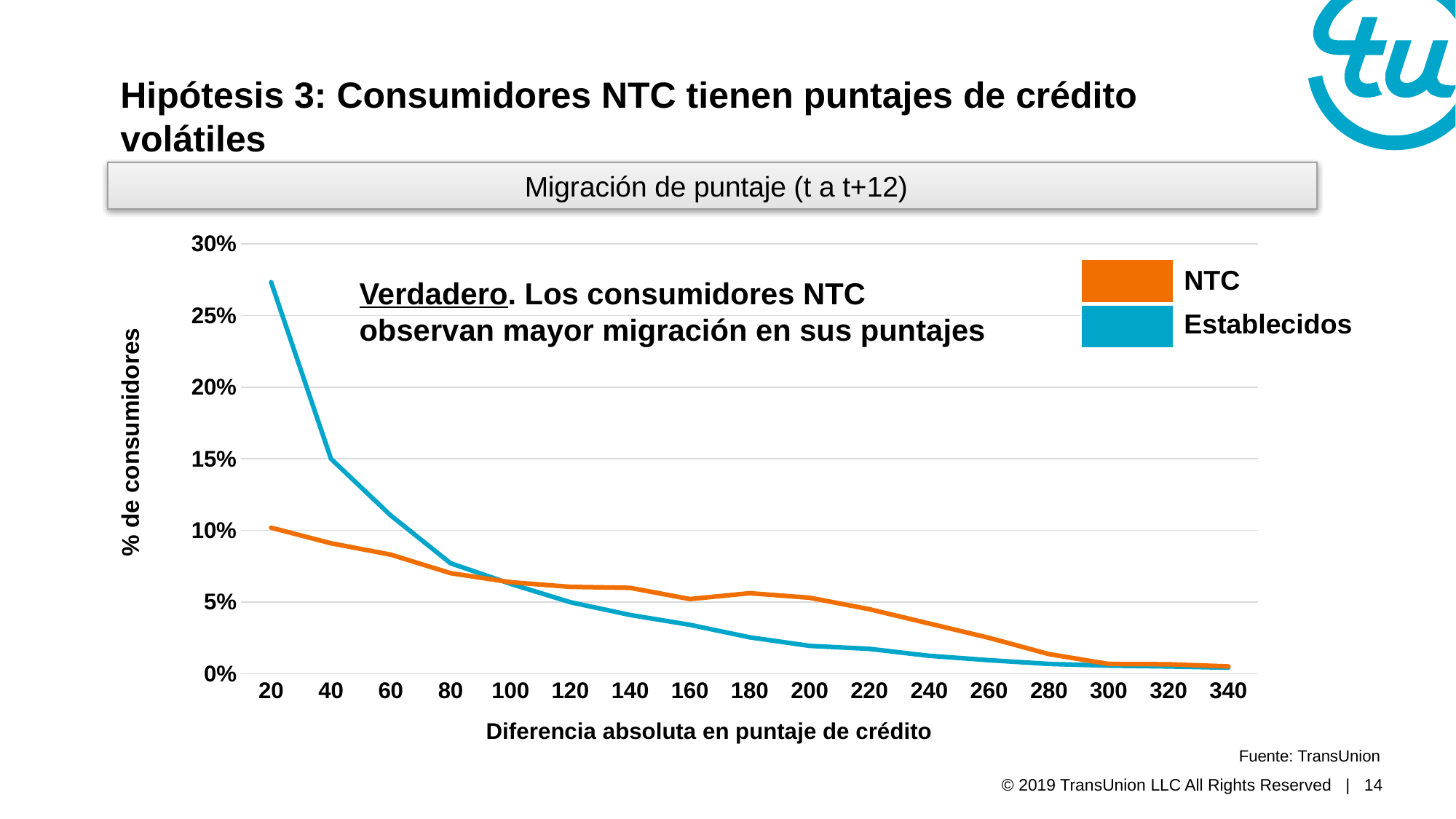
Is the value for Establecidos at 200 greater or less than 5%? less What is the title of the chart? Migración de puntaje (t a t+12) At 200, which series has the higher value, NTC or Establecidos? NTC Is the value for NTC at 40 greater or less than 10%? less At which x-axis value does the Establecidos series reach its highest point? 20 How many series does the legend list? 2 Is the value for Establecidos at 60 greater or less than 10%? greater How many points are marked along the x axis? 17 Do the values of the Establecidos series rise or fall as the x axis increases? fall What kind of chart is shown on the slide? line chart At 20, which series has the higher value, NTC or Establecidos? Establecidos